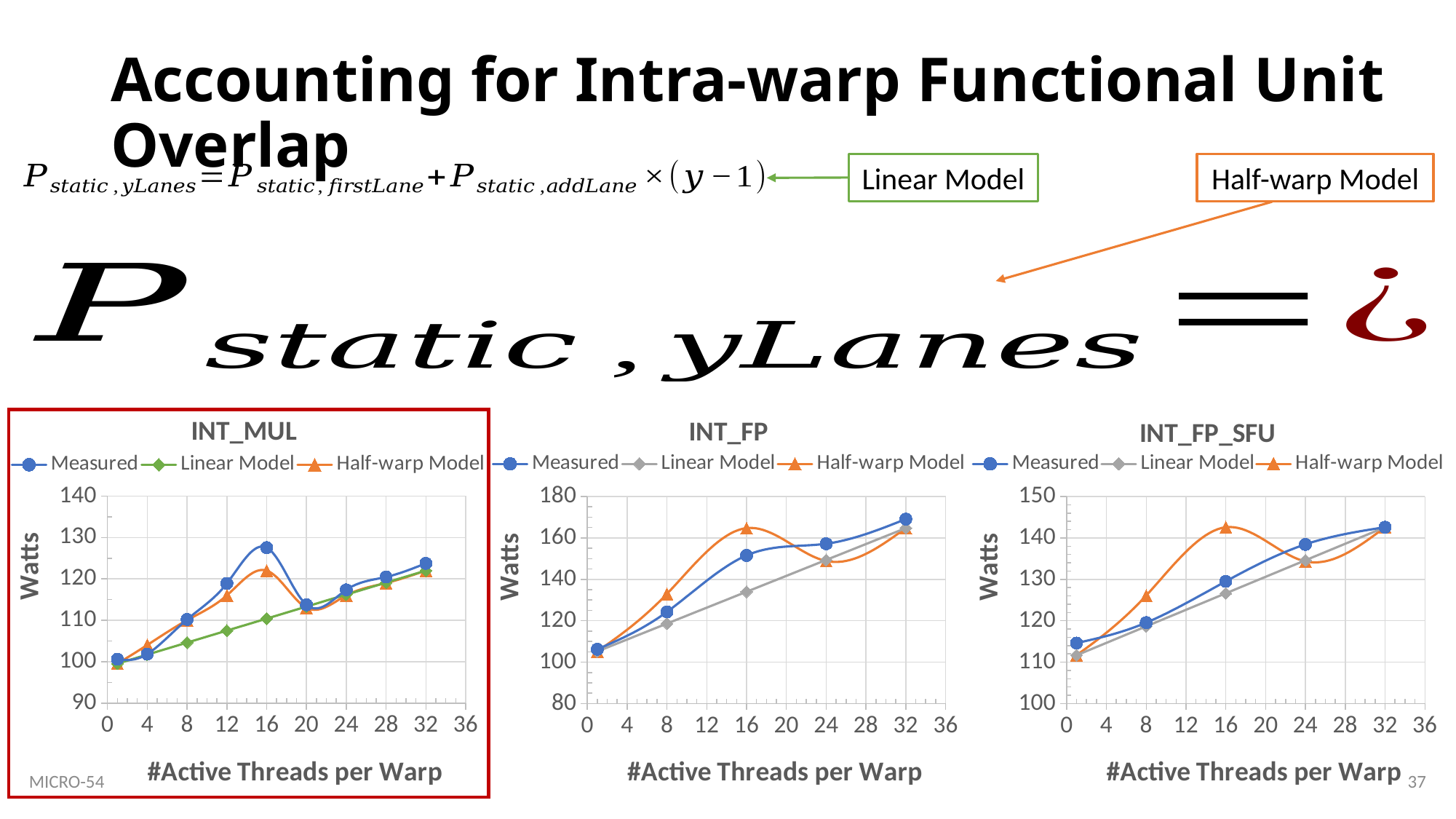
In the INT_FP_SFU chart, how many data points does the Measured series have? 5 In the INT_FP chart, is the Half-warp Model value at 16 active threads per warp greater or less than 160? greater In the INT_MUL chart, is the Linear Model value at 16 active threads per warp greater or less than 120? less Which of the three charts is outlined with a red border? INT_MUL In the INT_MUL chart, how many data points does the Measured series have? 9 How many series does the legend of the INT_FP chart list? 3 In the INT_MUL chart, is the Measured value at 16 active threads per warp greater or less than 120? greater What kind of chart is the INT_MUL chart? line chart In the INT_FP_SFU chart, at 16 active threads per warp, which is larger: the Half-warp Model value or the Linear Model value? Half-warp Model In the INT_MUL chart, which series has the highest value at 16 active threads per warp? Measured In the INT_FP chart, does the Linear Model series rise or fall as the number of active threads per warp increases? rise